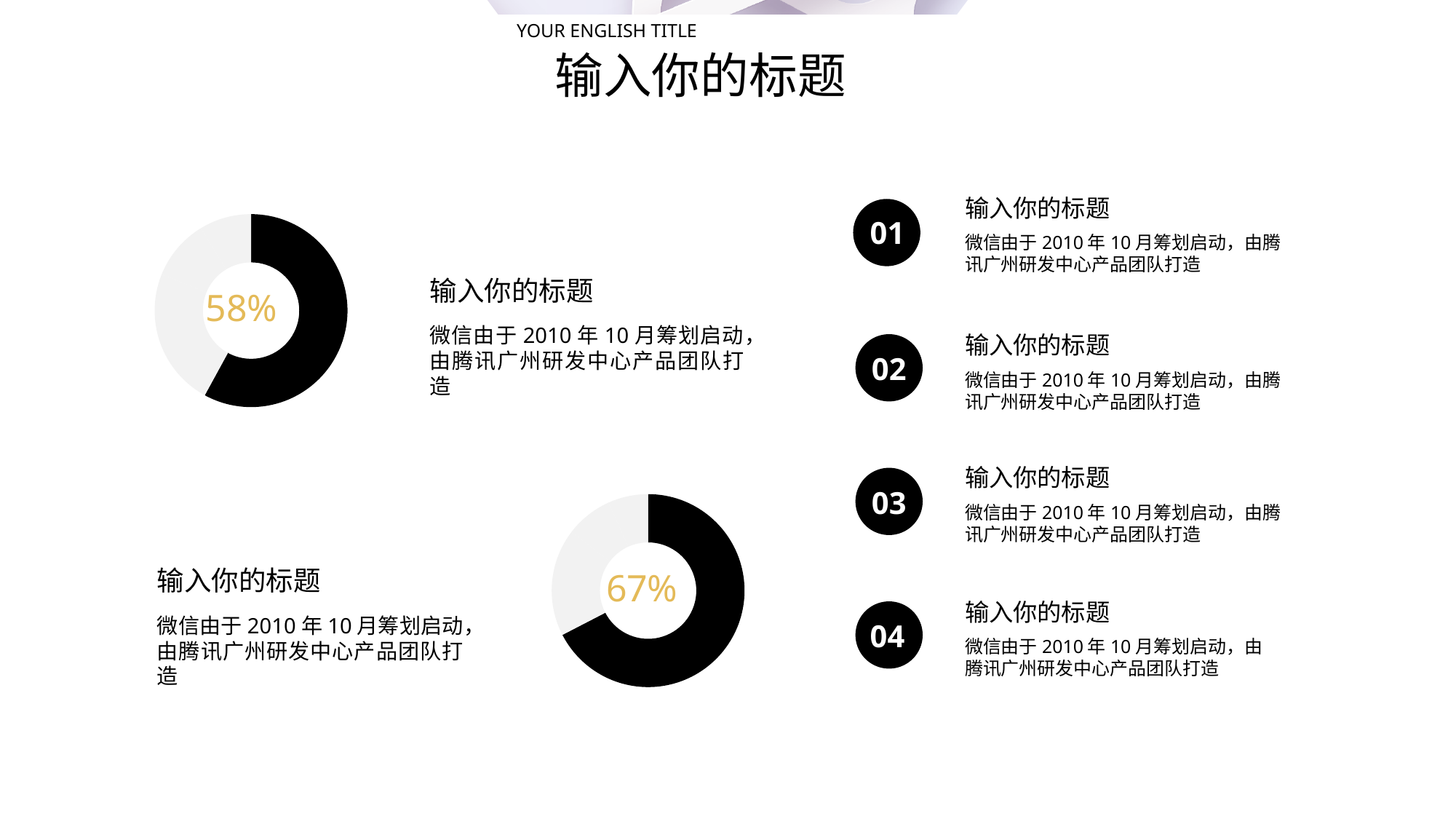
In the lower donut chart, is the value shown greater or less than 70%? less What percentage is shown in the centre of the upper-left donut chart? 58% What is the difference between the percentages shown in the two donut charts? 9% What kind of chart is the lower chart showing 67%? donut chart In the lower donut chart, what share of the ring is not filled in black? 33% Which donut chart shows the larger percentage, the upper-left one or the lower one? the lower one (67%) In the upper-left donut chart, is the value shown greater or less than 50%? greater In the upper-left donut chart, what share of the ring is not filled in black? 42% How many donut charts are on the slide? 2 What percentage is shown in the centre of the lower donut chart? 67% What colour is the filled portion of the ring in both donut charts? black What kind of chart is the upper-left chart showing 58%? donut chart